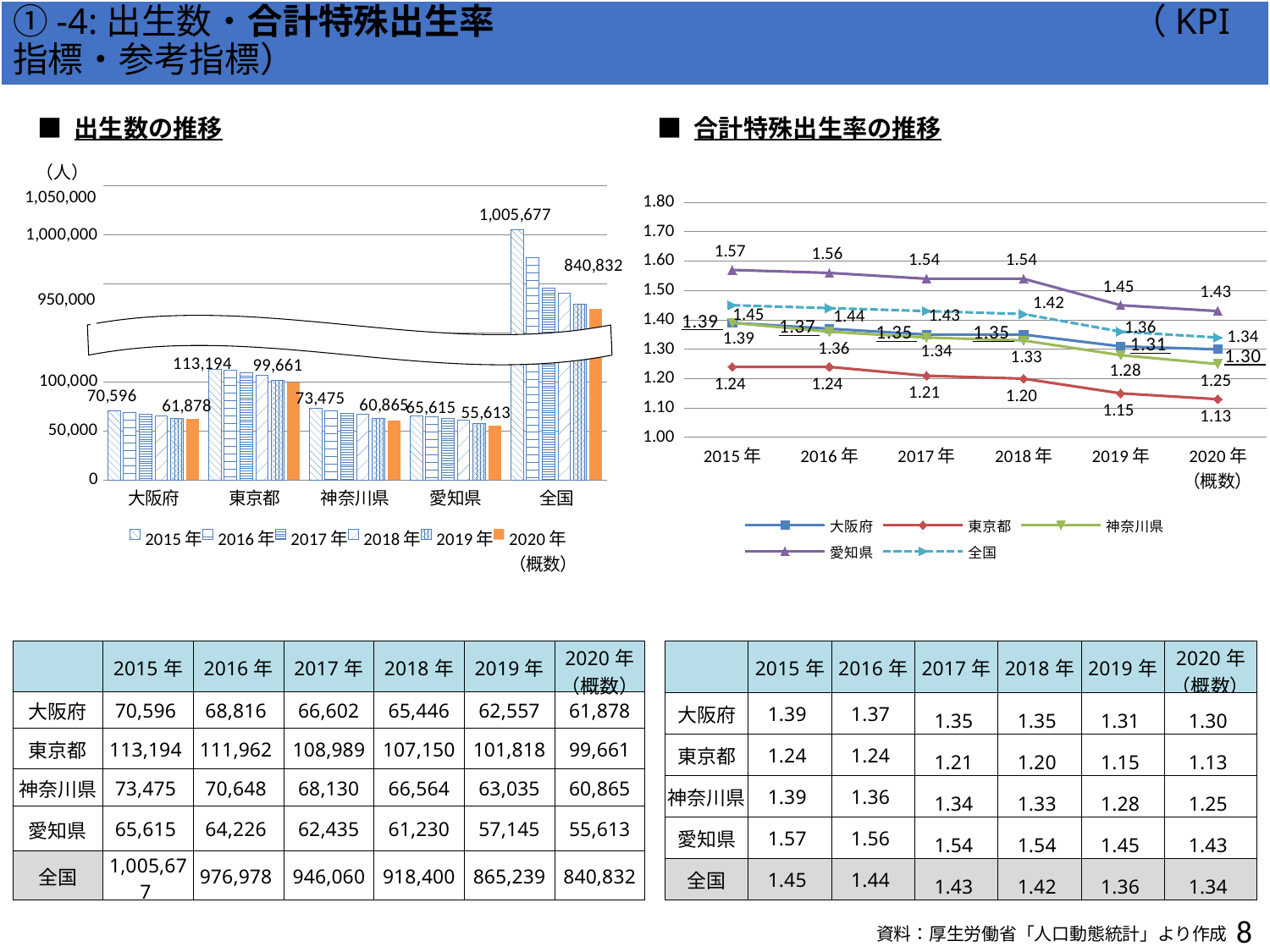
In the right chart 合計特殊出生率の推移, which series has the lowest value in 2020年(概数)? 東京都 What kind of chart is the left chart titled 出生数の推移? bar chart In the right chart 合計特殊出生率の推移, which is larger in 2019年: 大阪府 or 神奈川県? 大阪府 What kind of chart is the right chart titled 合計特殊出生率の推移? line chart In the right chart 合計特殊出生率の推移, does the value for 全国 rise or fall from 2015年 to 2020年(概数)? fall In the left chart 出生数の推移, how many categories are shown on the x axis? 5 In the right chart 合計特殊出生率の推移, what is the value for 愛知県 in 2015年? 1.57 In the left chart 出生数の推移, what is the difference between the 2015年 and 2020年(概数) values for 大阪府? 8,718 In the left chart 出生数の推移, how many series does the legend list? 6 In the left chart 出生数の推移, what is the value for 全国 in 2015年? 1,005,677 In the right chart 合計特殊出生率の推移, how many series does the legend list? 5 In the left chart 出生数の推移, what is the value for 東京都 in 2020年(概数)? 99,661